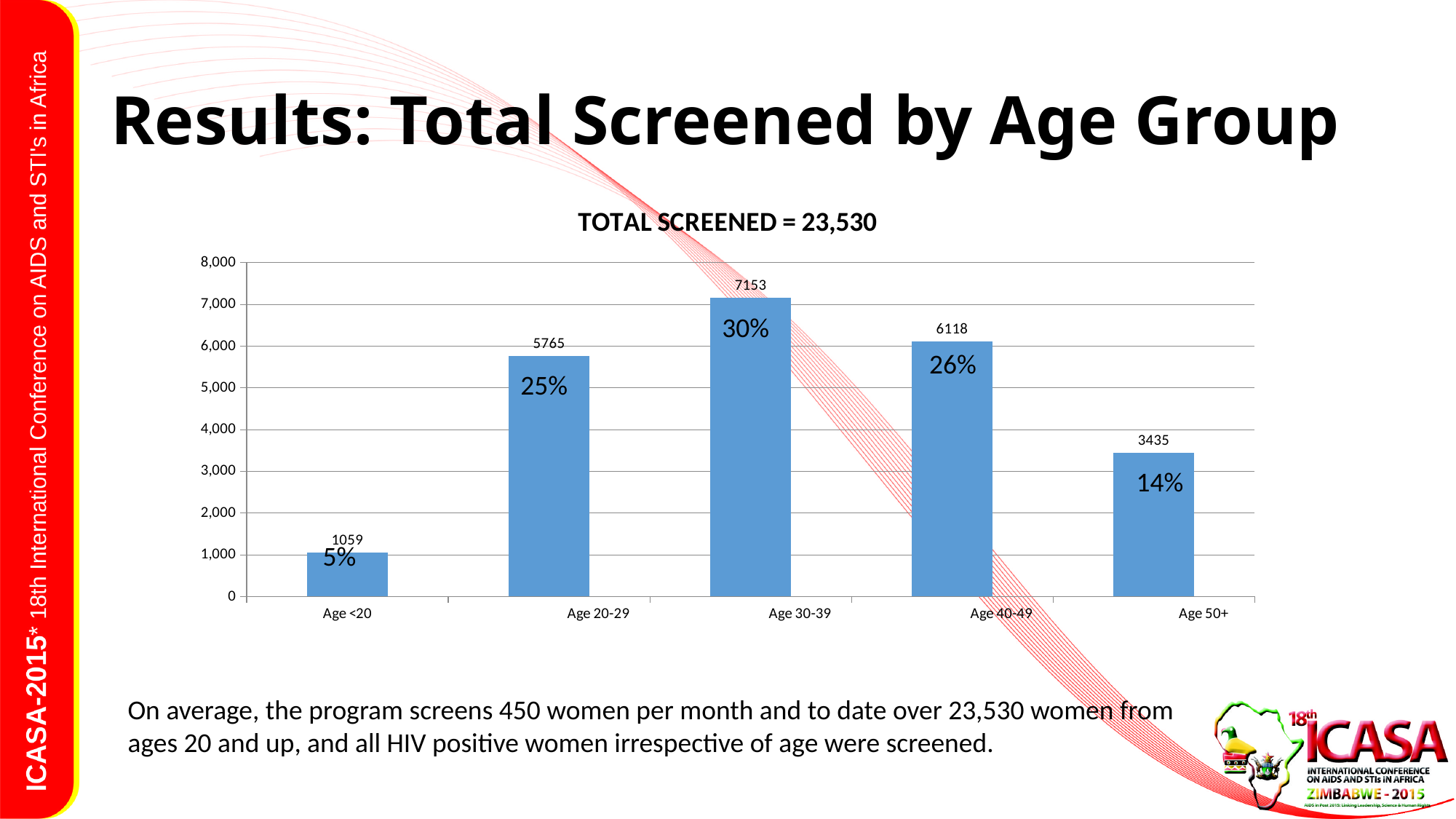
Which age group has the highest number screened? Age 30-39 Is the value for Age 50+ greater or less than 3,000? greater How many age groups are shown on the chart? 5 What kind of chart is shown on the slide? Bar chart Which group has more women screened, Age 20-29 or Age 50+? Age 20-29 What is the difference between the number screened in Age 20-29 and Age 50+? 2330 What percentage label is shown on the Age 40-49 bar? 26% What is the value shown for the Age <20 group? 1059 What is the difference between the number screened in Age 30-39 and Age 40-49? 1035 How many women were screened in the Age 30-39 group? 7153 What is the chart's title? TOTAL SCREENED = 23,530 Which age group has the lowest number screened? Age <20